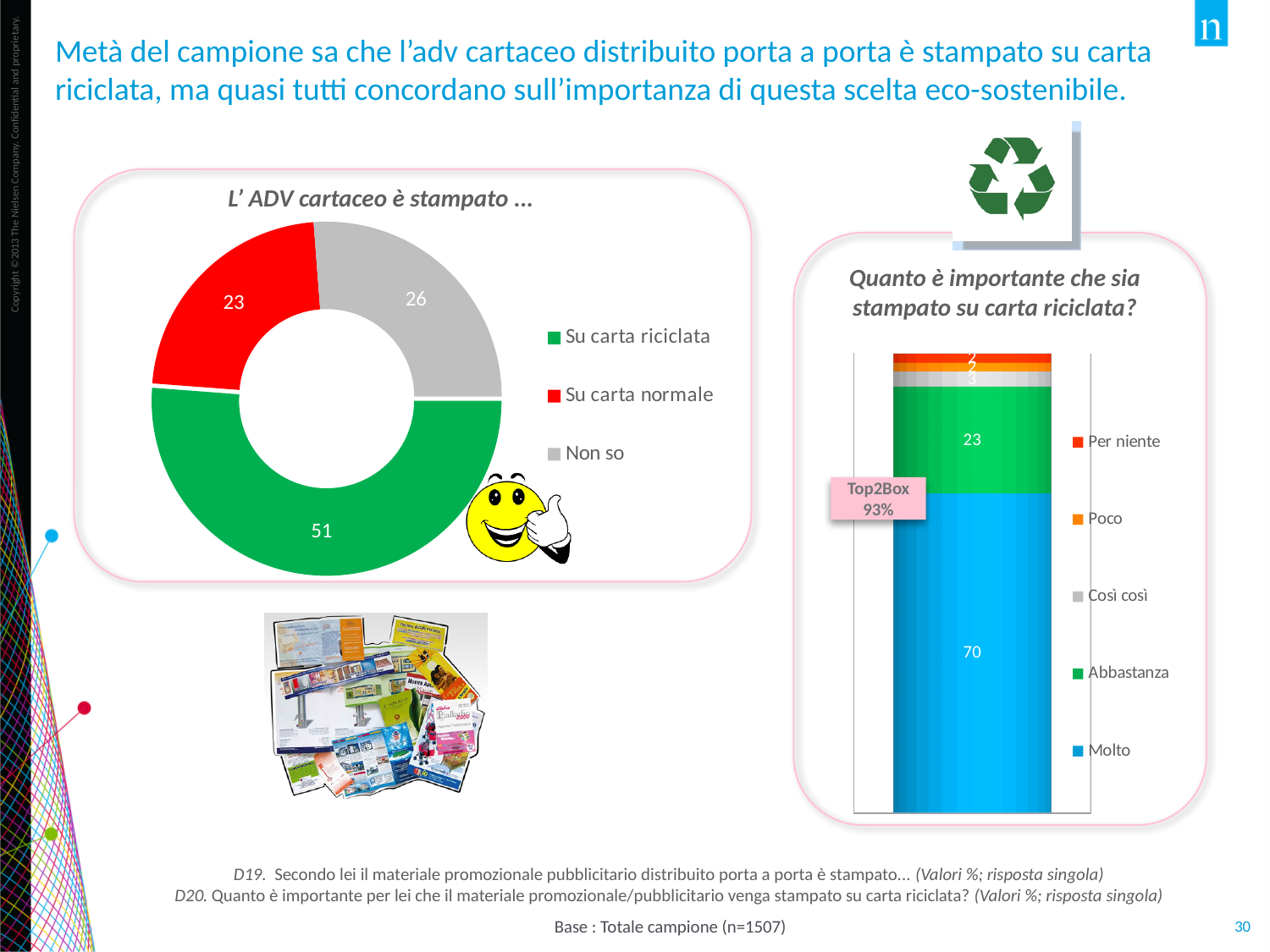
In the chart titled "Quanto è importante che sia stampato su carta riciclata?", what is the combined value of "Molto" and "Abbastanza"? 93 In the chart titled "L' ADV cartaceo è stampato ...", what is the difference between "Su carta riciclata" and "Su carta normale"? 28 In the chart titled "L' ADV cartaceo è stampato ...", what is the value for "Su carta riciclata"? 51 In the chart titled "Quanto è importante che sia stampato su carta riciclata?", which is larger, "Molto" or "Abbastanza"? Molto In the chart titled "L' ADV cartaceo è stampato ...", how many categories does the legend list? 3 In the chart titled "L' ADV cartaceo è stampato ...", which category has the smallest value? Su carta normale In the chart titled "Quanto è importante che sia stampato su carta riciclata?", how many series does the legend list? 5 What kind of chart is the one titled "L' ADV cartaceo è stampato ..."? Doughnut chart In the chart titled "L' ADV cartaceo è stampato ...", what is the value for "Non so"? 26 In the chart titled "L' ADV cartaceo è stampato ...", which category has the largest value? Su carta riciclata In the chart titled "Quanto è importante che sia stampato su carta riciclata?", what is the value for "Abbastanza"? 23 In the chart titled "Quanto è importante che sia stampato su carta riciclata?", what is the value for "Molto"? 70